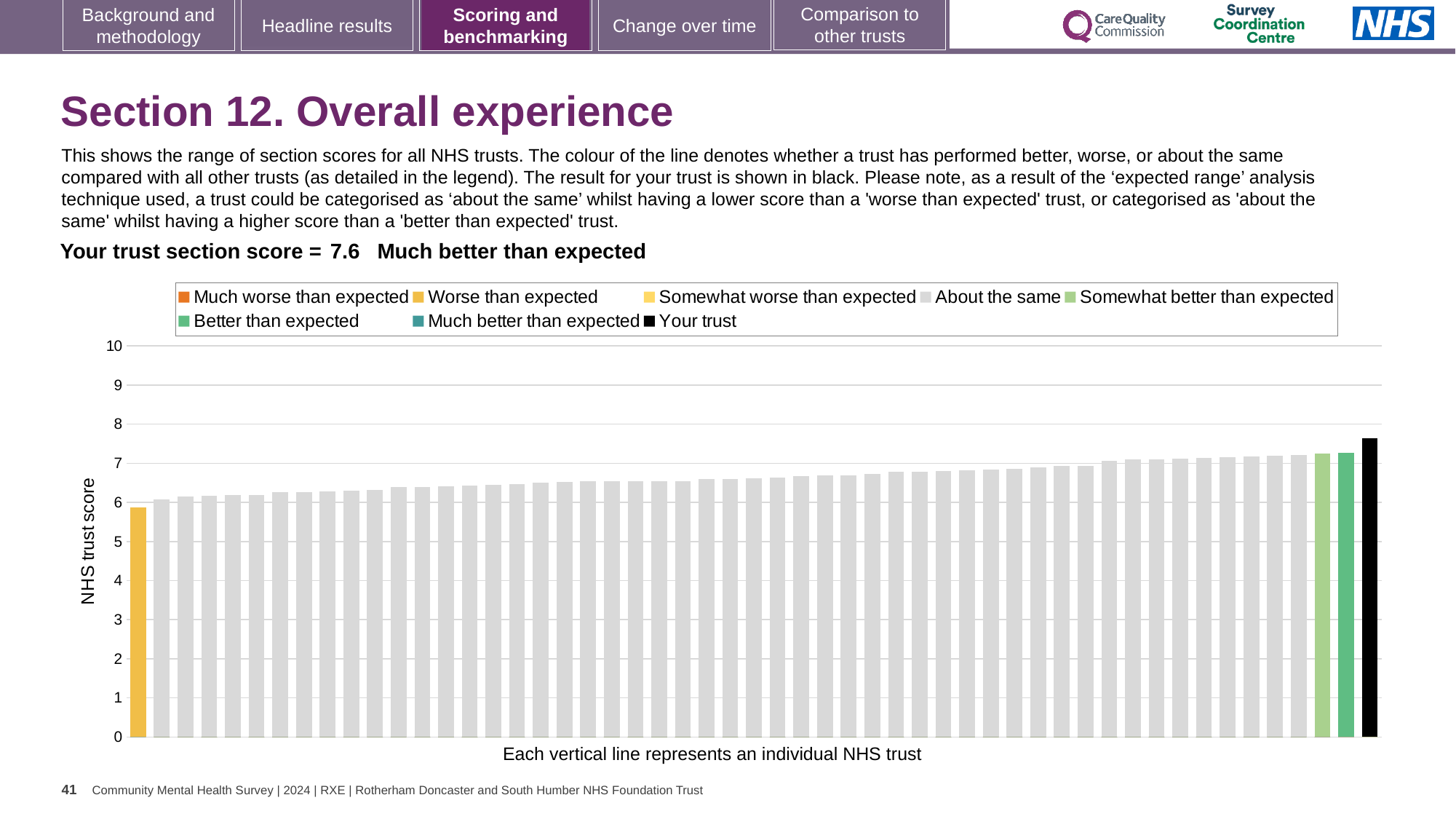
Is the value for your trust greater or less than 7? greater Do the bar values rise or fall from left to right along the x axis? Rise What colour is used for the 'Your trust' bar in the chart? Black Is the value for the lowest bar (Worse than expected) greater or less than 7? less Which bar in the chart is the highest? Your trust (the black bar) What is the section score for your trust shown on the slide? 7.6 What kind of chart is shown on the slide? Bar chart How many entries does the chart legend list? 8 Is the value for your trust greater or less than 8? less Which category does the lowest bar in the chart belong to? Worse than expected What is the label on the vertical axis of the chart? NHS trust score How is your trust's section score of 7.6 categorised on the slide? Much better than expected